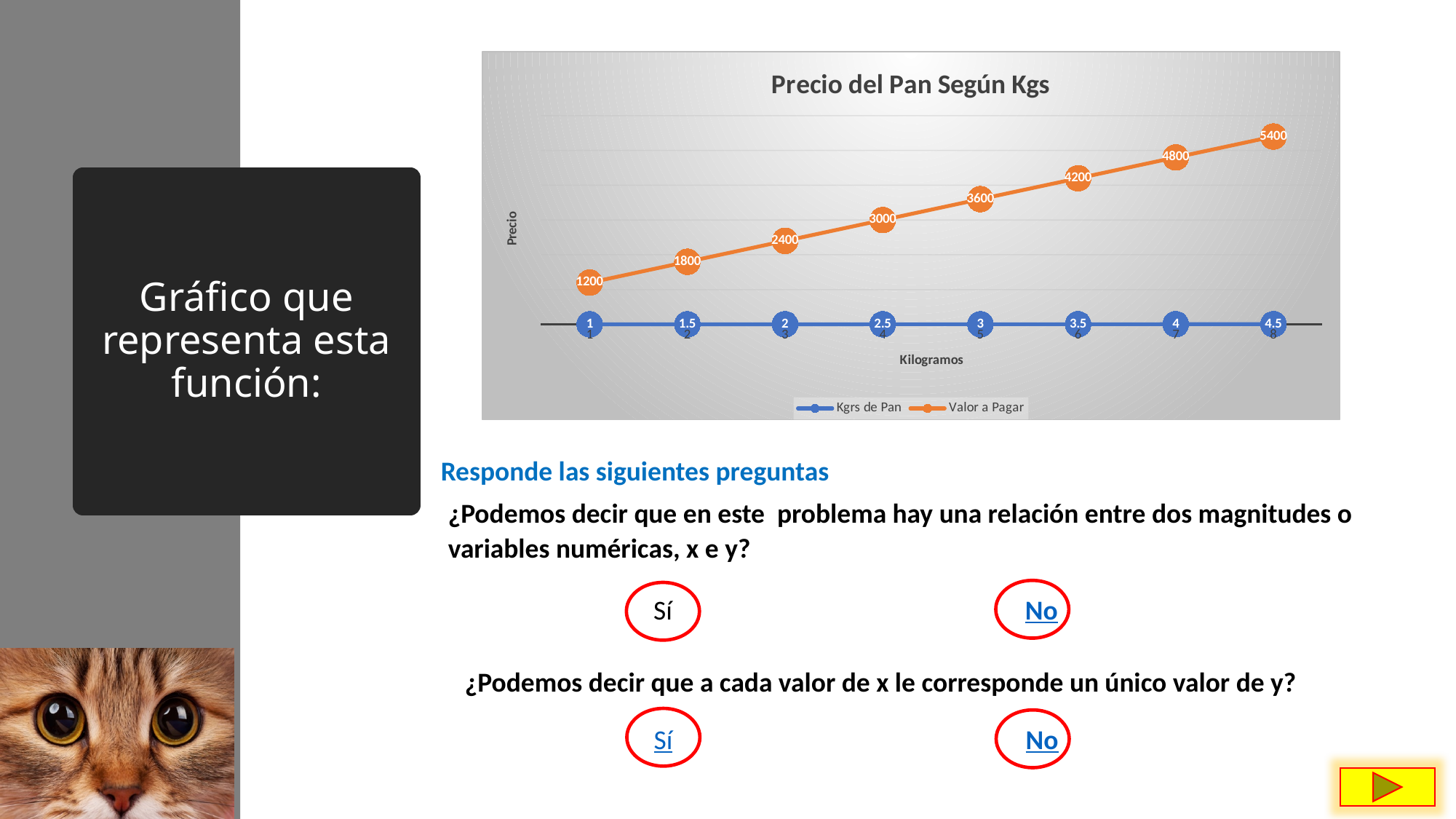
What is the Valor a Pagar value at category 1? 1200 What is the Valor a Pagar value at category 5? 3600 What is the difference between the Valor a Pagar values at category 8 and category 1? 4200 What is the lowest Kgrs de Pan value shown? 1 How many series does the legend list? 2 Which series is drawn in orange? Valor a Pagar What type of chart is shown on the slide? line chart What is the Kgrs de Pan value at category 4? 2.5 Does the Valor a Pagar series rise or fall along the x axis? rise What is the title of the chart? Precio del Pan Según Kgs What is the highest Valor a Pagar value shown? 5400 How many data points does the Valor a Pagar series have? 8